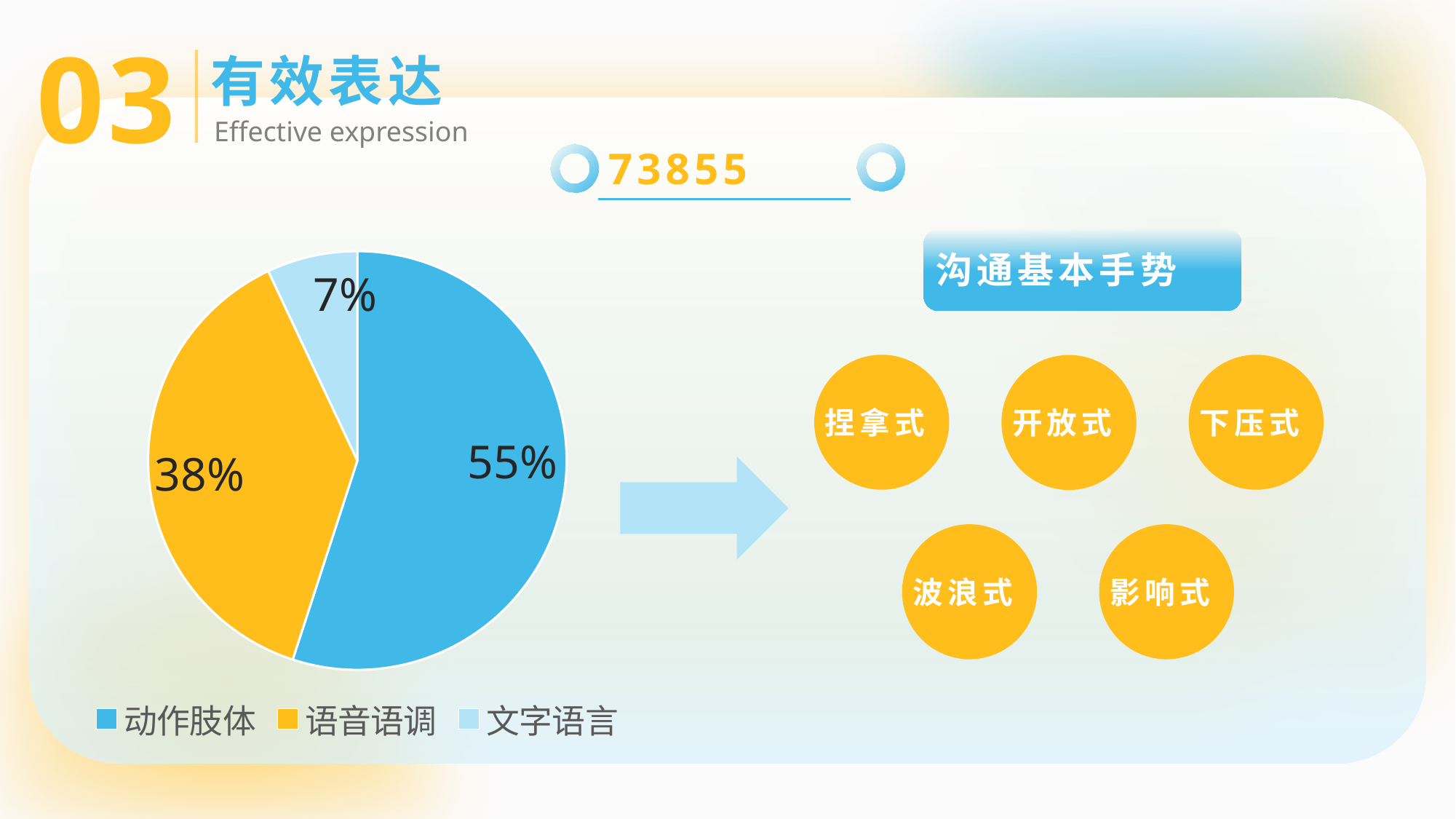
What share of the pie does 文字语言 represent? 7% What kind of chart is shown on the slide? pie chart Which is larger, the share of 语音语调 or the share of 文字语言? 语音语调 How many slices does the pie chart have? 3 What is the difference between the shares of 语音语调 and 文字语言? 31% What share of the pie does 动作肢体 represent? 55% What colour is the slice for 语音语调? yellow Which category has the smallest slice of the pie? 文字语言 Is the share of 动作肢体 greater or less than 50%? greater What share of the pie does 语音语调 represent? 38% What is the difference between the shares of 动作肢体 and 语音语调? 17% Which category has the largest slice of the pie? 动作肢体